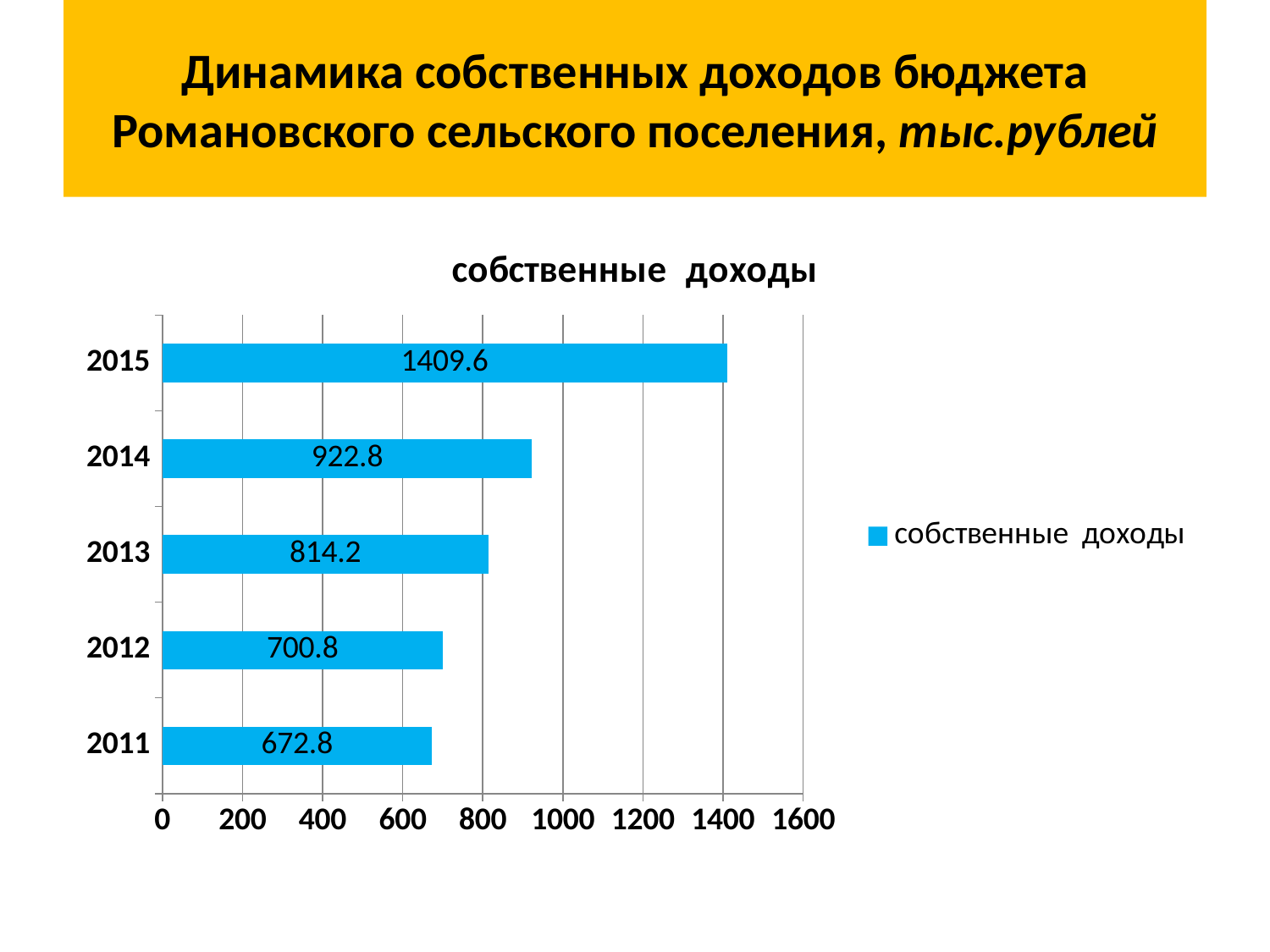
What is the difference between the values for 2012 and 2011? 28 Which year has the highest value? 2015 What is the difference between the values for 2015 and 2014? 486.8 Which year has the lowest value? 2011 How many years are shown in the chart? 5 What is the value for 2015? 1409.6 What is the value for 2013? 814.2 Which is larger, the value for 2014 or the value for 2013? 2014 What is the title of the chart? собственные доходы What is the value for 2011? 672.8 What kind of chart is shown on the slide? bar chart Is the value for 2014 greater or less than 1000? less